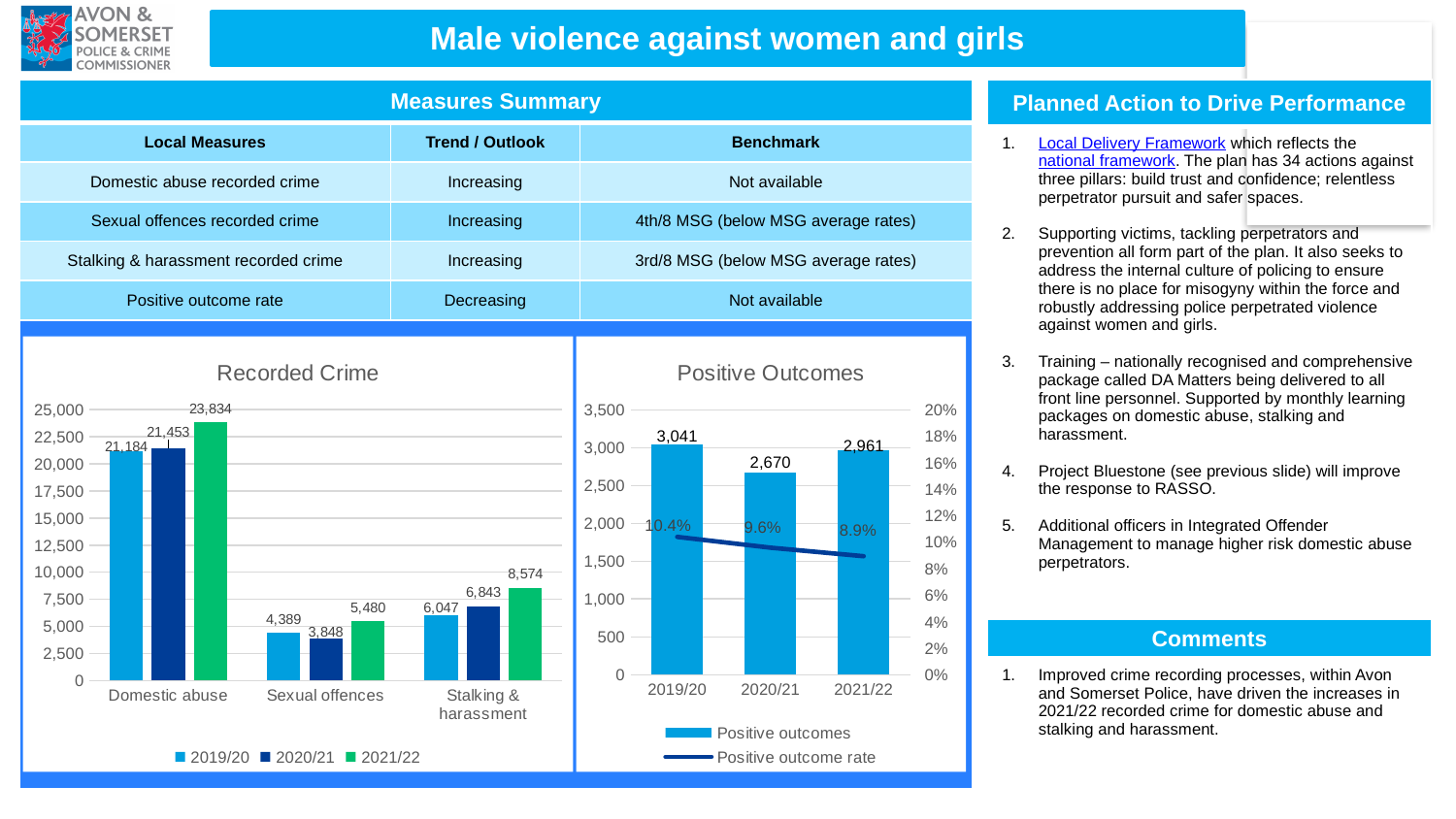
What kind of chart is the Recorded Crime chart? Bar chart In the Positive Outcomes chart, does the positive outcome rate rise or fall from 2019/20 to 2021/22? Fall In the Recorded Crime chart, what is the difference between the 2021/22 and 2020/21 values for Stalking & harassment? 1,731 In the Recorded Crime chart, how many series does the legend list? 3 In the Positive Outcomes chart, what is the positive outcome rate in 2021/22? 8.9% In the Recorded Crime chart, which category has the highest value in 2021/22? Domestic abuse In the Recorded Crime chart, what is the value for Sexual offences in 2020/21? 3,848 In the Recorded Crime chart, which category has the lowest value in 2020/21? Sexual offences In the Recorded Crime chart, what is the value for Domestic abuse in 2021/22? 23,834 In the Positive Outcomes chart, which year has the highest number of positive outcomes? 2019/20 In the Positive Outcomes chart, what is the number of positive outcomes in 2020/21? 2,670 In the Recorded Crime chart, what is the value for Stalking & harassment in 2019/20? 6,047